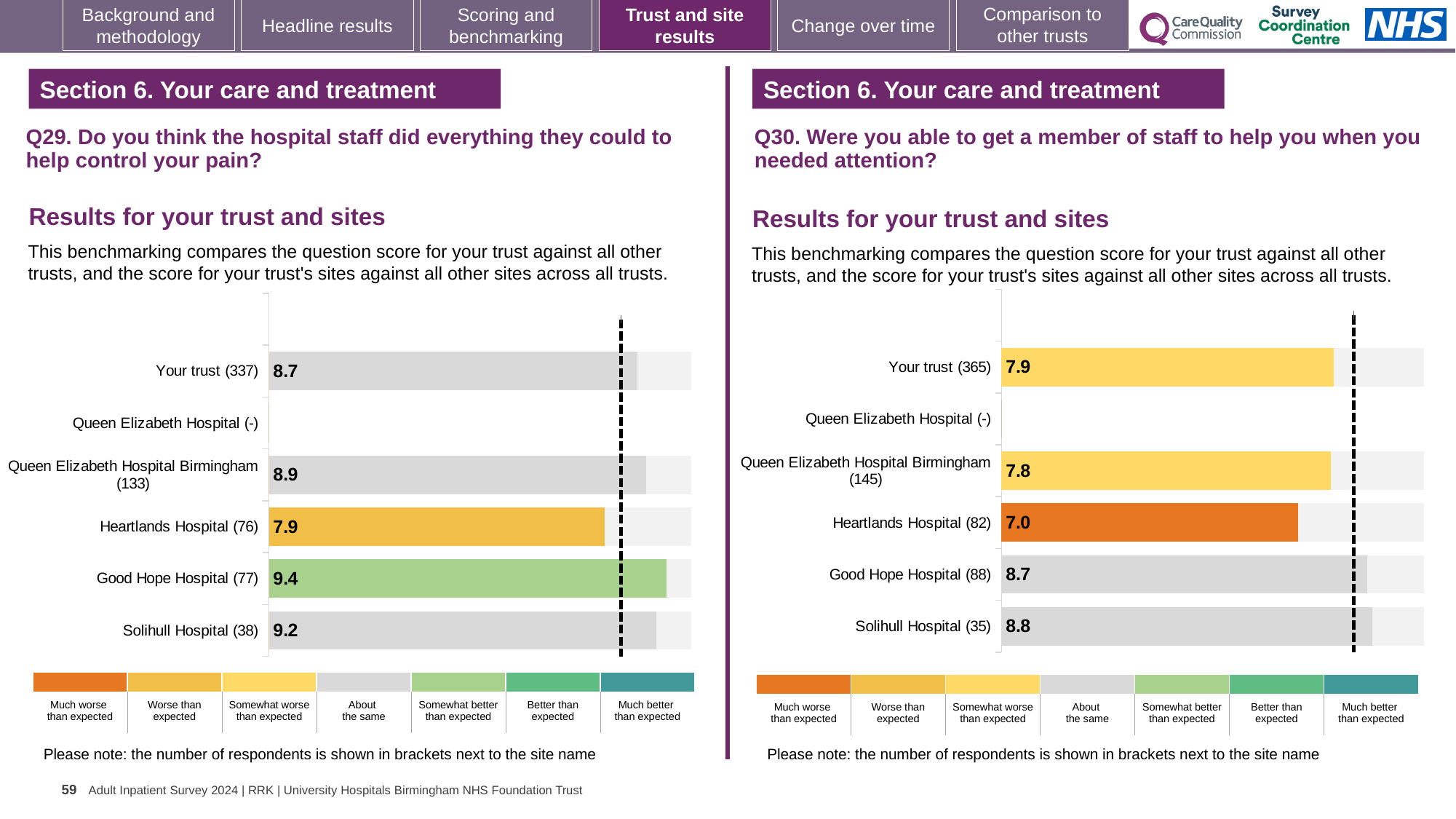
In the Q30 chart on the right, what is the score for Heartlands Hospital? 7.0 In the Q29 chart on the left, which site has the lowest score? Heartlands Hospital In the Q30 chart on the right, which is larger: the score for Your trust or the score for Queen Elizabeth Hospital Birmingham? Your trust In the Q29 chart on the left, which site has the highest score? Good Hope Hospital What kind of chart is used in the Q29 chart on the left? Bar chart In the Q30 chart on the right, which site has the highest score? Solihull Hospital In the Q29 chart on the left, what is the score for Your trust? 8.7 In the Q29 chart on the left, how many categories does the legend below the chart list? 7 In the Q29 chart on the left, what is the difference between the scores for Good Hope Hospital and Heartlands Hospital? 1.5 In the Q29 chart on the left, what is the score for Good Hope Hospital? 9.4 In the Q30 chart on the right, what is the difference between the scores for Good Hope Hospital and Heartlands Hospital? 1.7 In the Q30 chart on the right, what is the score for Solihull Hospital? 8.8